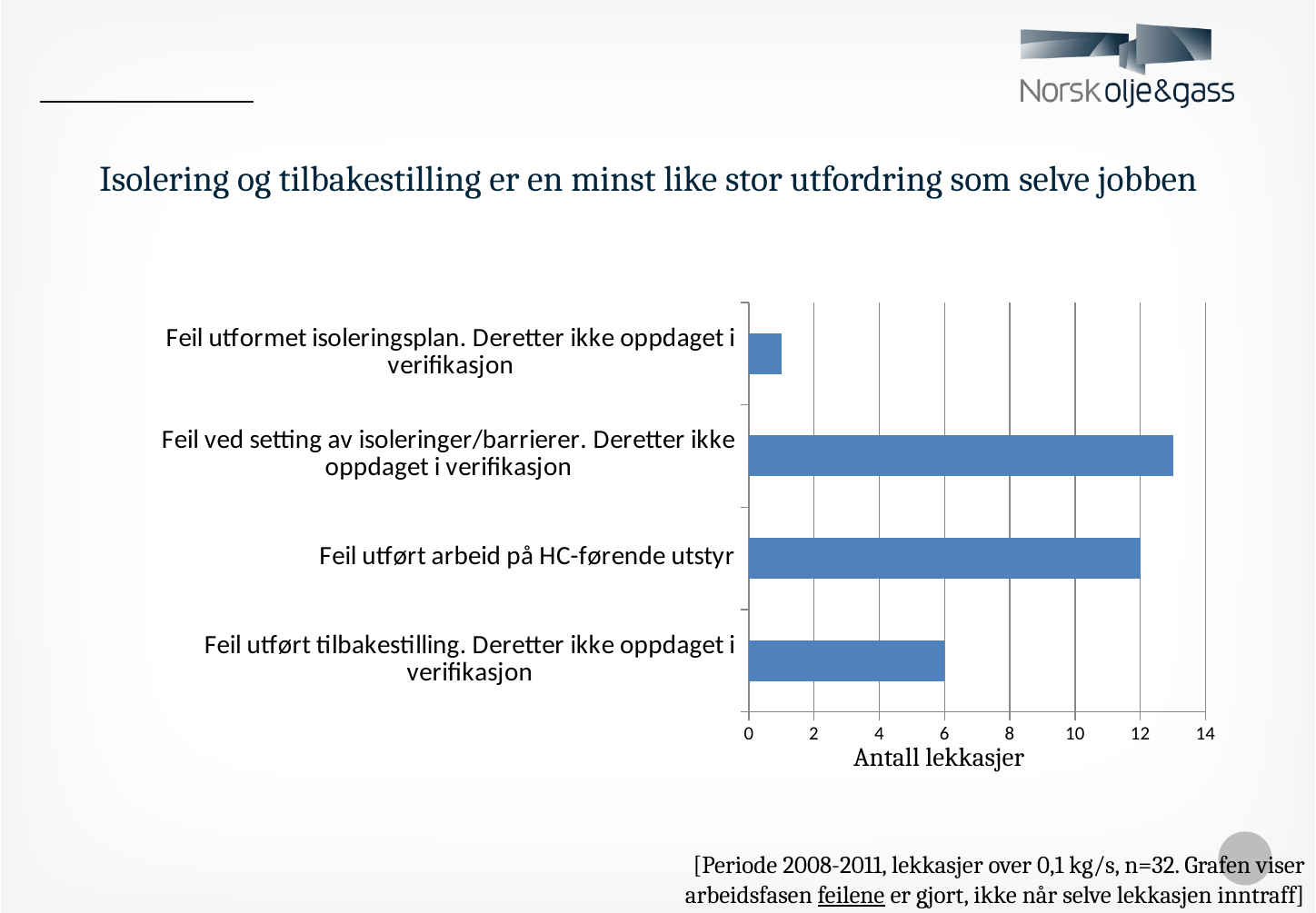
Which is larger: the value for "Feil utført arbeid på HC-førende utstyr" or the value for "Feil utført tilbakestilling. Deretter ikke oppdaget i verifikasjon"? Feil utført arbeid på HC-førende utstyr What kind of chart is shown on the slide? bar chart What is the maximum value shown on the horizontal axis? 14 Which category has the highest value? Feil ved setting av isoleringer/barrierer. Deretter ikke oppdaget i verifikasjon Is the value for "Feil utformet isoleringsplan. Deretter ikke oppdaget i verifikasjon" greater or less than 2? less What is the value for "Feil utført tilbakestilling. Deretter ikke oppdaget i verifikasjon"? 6 Which category has the lowest value? Feil utformet isoleringsplan. Deretter ikke oppdaget i verifikasjon How many categories does the chart show? 4 Is the value for "Feil ved setting av isoleringer/barrierer. Deretter ikke oppdaget i verifikasjon" greater or less than 12? greater What is the label of the horizontal axis? Antall lekkasjer What is the difference between the values for "Feil utført arbeid på HC-førende utstyr" and "Feil utført tilbakestilling. Deretter ikke oppdaget i verifikasjon"? 6 What is the value for "Feil utført arbeid på HC-førende utstyr"? 12